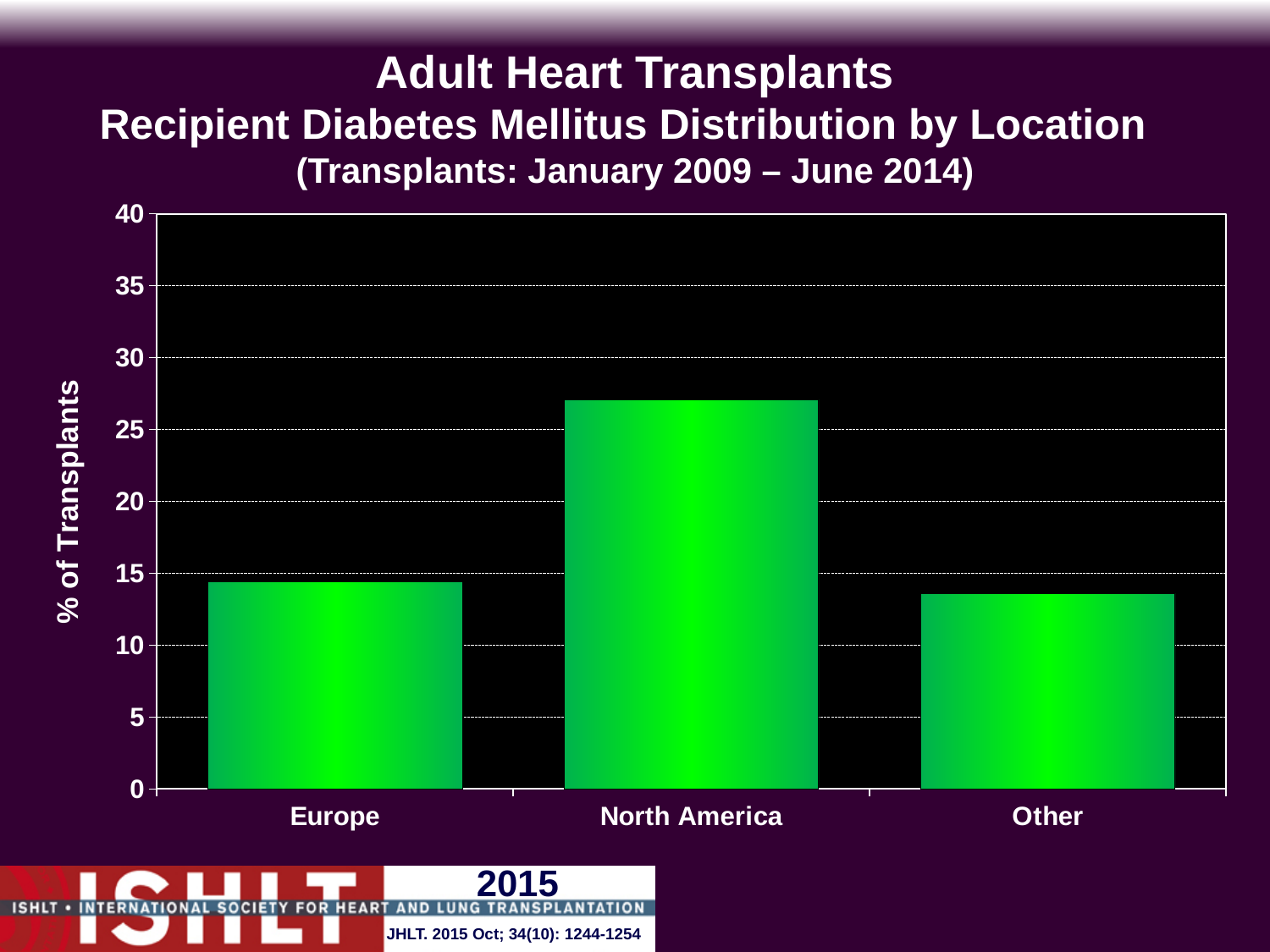
Is the value for Europe greater or less than 15? less How many location categories are shown on the x axis? 3 Which location has the highest % of transplants? North America Is the value for North America greater or less than 30? less What transplant period is given in the chart title? January 2009 – June 2014 Is the value for Other greater or less than 10? greater What is the label of the y axis? % of Transplants Which is larger, the value for North America or the value for Europe? North America What type of chart is shown on the slide? bar chart